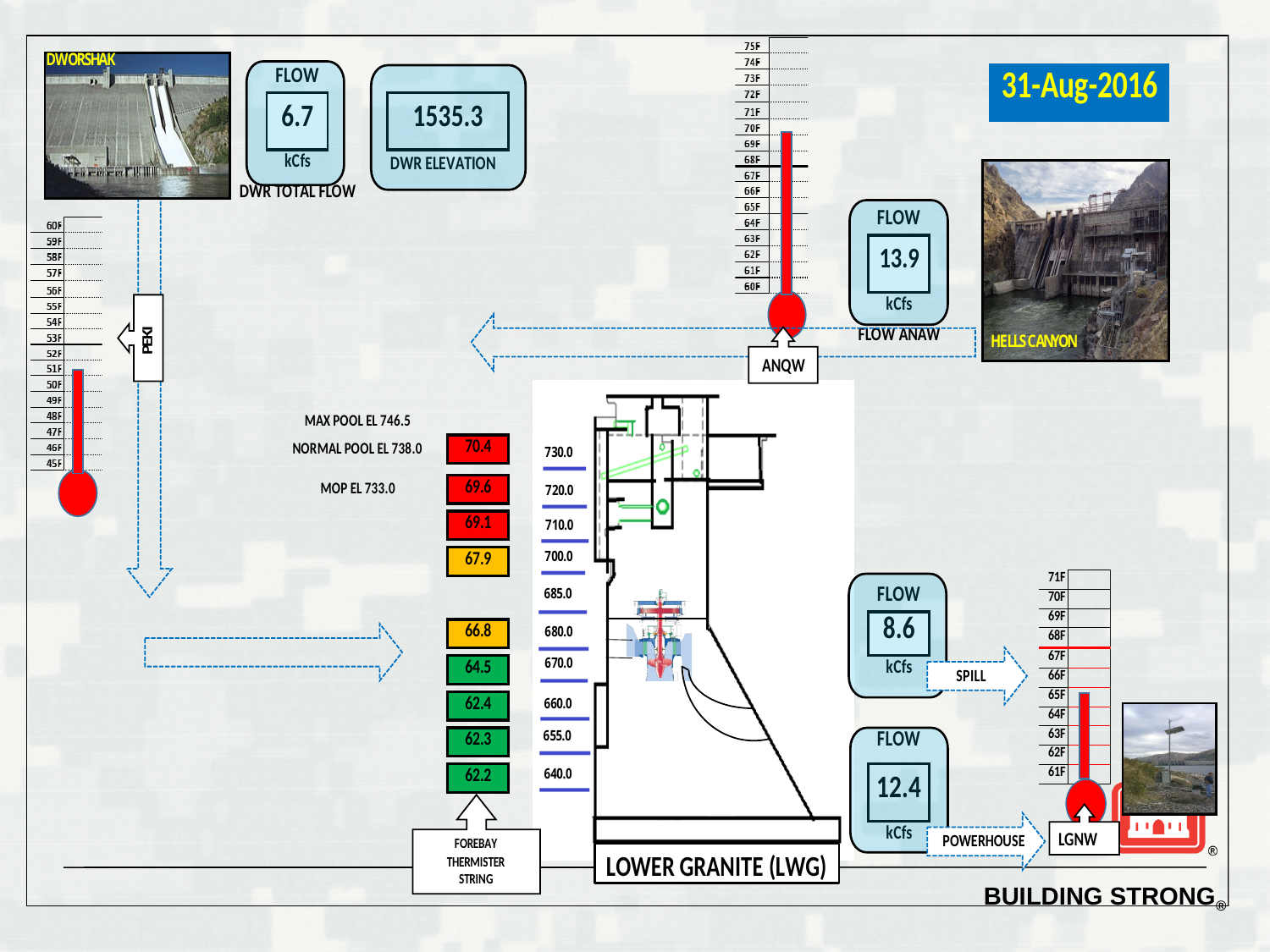
Is the red fill of the LGNW thermometer greater or less than 68F? less What is the POWERHOUSE flow value shown for Lower Granite? 12.4 kCfs Which is larger at Lower Granite, the SPILL flow or the POWERHOUSE flow? POWERHOUSE What is the difference between the POWERHOUSE flow and the SPILL flow at Lower Granite? 3.8 kCfs What is the FLOW ANAW value shown next to the Hells Canyon image? 13.9 kCfs What is the highest value shown in the FOREBAY THERMISTER STRING column? 70.4 How many values are shown in the FOREBAY THERMISTER STRING column? 9 What is the SPILL flow value shown for Lower Granite? 8.6 kCfs What is the DWR ELEVATION value shown on the slide? 1535.3 Is the red fill of the ANQW thermometer greater or less than 65F? greater What is the DWR total flow value shown in the FLOW box next to the Dworshak image? 6.7 kCfs What is the lowest value shown in the FOREBAY THERMISTER STRING column? 62.2